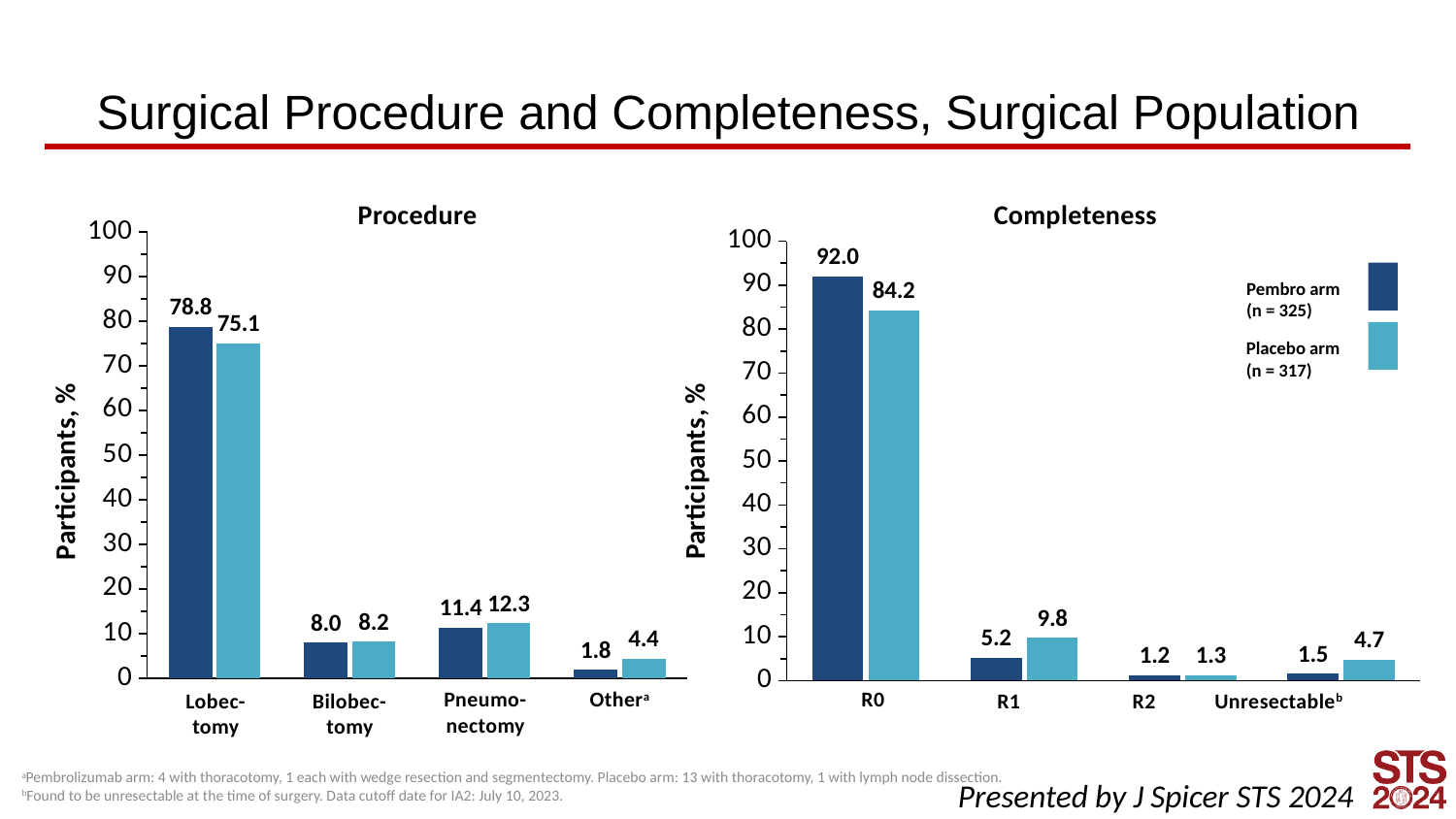
In the Completeness chart, what is the Placebo arm value for R1? 9.8 How many series does the legend list? 2 In the Procedure chart, what percentage of participants in the Pembro arm had a lobectomy? 78.8 In the Procedure chart, what is the Placebo arm value for pneumonectomy? 12.3 How many categories are shown on the x axis of the Completeness chart? 4 In the Procedure chart, which arm has the larger value for Other: Pembro or Placebo? Placebo arm In the Completeness chart, what is the Pembro arm value for R0? 92.0 In the Completeness chart, which category has the lowest value for the Pembro arm? R2 What is the y-axis label of the Completeness chart? Participants, % In the Procedure chart, which procedure has the highest value for the Placebo arm? Lobectomy What kind of chart is the Procedure chart? Bar chart In the Completeness chart, what is the difference between the Pembro arm and Placebo arm values for R0? 7.8